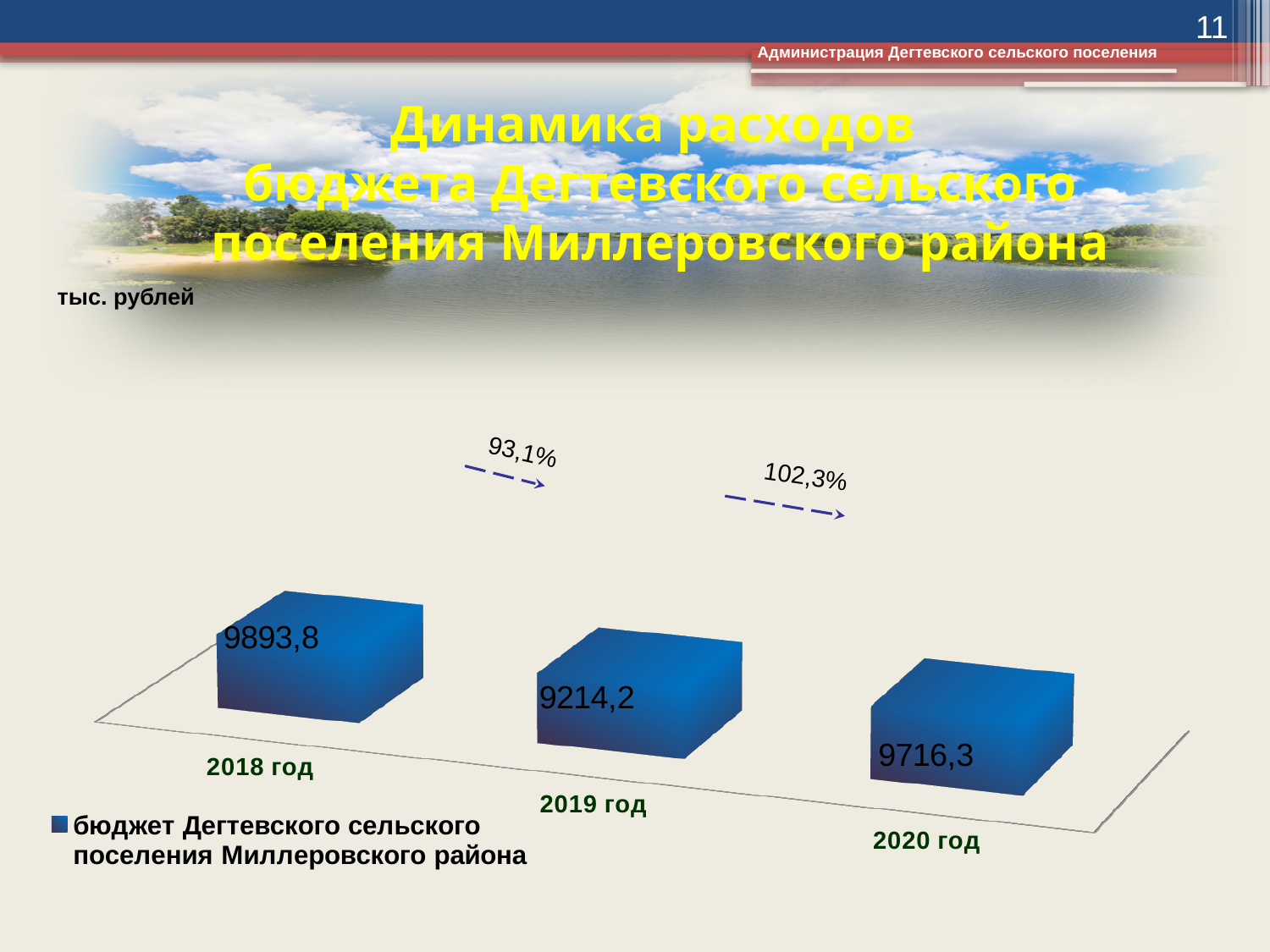
What is the value for 2019 год? 9214,2 How many years are shown on the chart? 3 How many series does the legend list? 1 What is the value for 2020 год? 9716,3 What kind of chart is shown on the slide? bar chart Does the value rise or fall from 2018 год to 2019 год? fall What is the difference between the values for 2018 год and 2019 год? 679,6 Which year has the lowest value? 2019 год What is the value for 2018 год? 9893,8 Which is larger, the value for 2018 год or the value for 2020 год? 2018 год What is the difference between the values for 2020 год and 2019 год? 502,1 Which year has the highest value? 2018 год